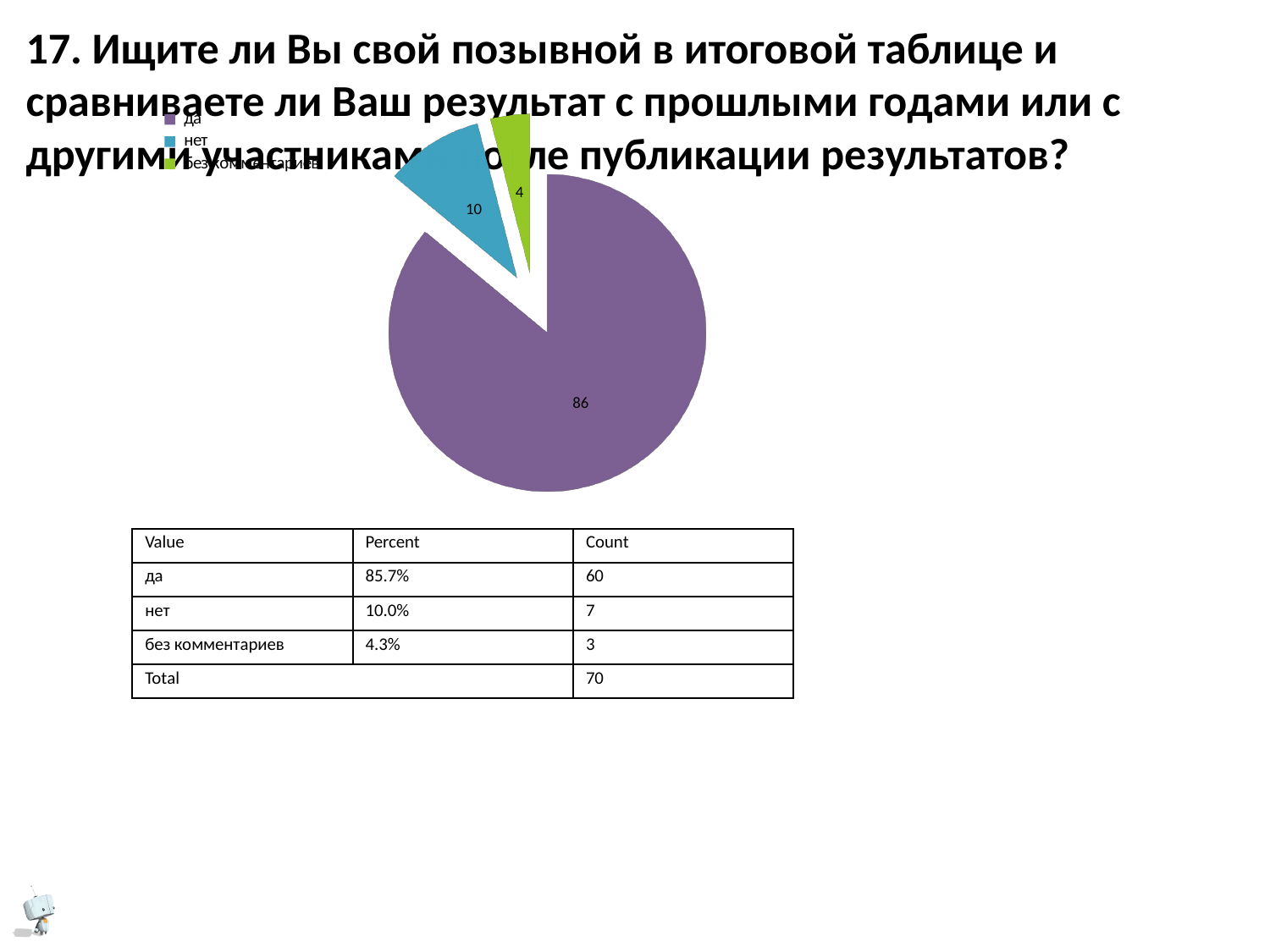
What value is printed on the largest slice of the pie chart? 86 Which slice is larger in the pie chart, "нет" or "без комментариев"? нет What kind of chart is shown on the slide? pie chart What is the difference between the values printed on the "да" slice and the "нет" slice? 76 Which category has the smallest slice in the pie chart? без комментариев What value is printed on the slice for "нет" in the pie chart? 10 What value is printed on the smallest slice of the pie chart? 4 What colour is the slice labelled 4 in the pie chart? green How many entries does the legend of the pie chart list? 3 Which category has the largest slice in the pie chart? да How many slices does the pie chart have? 3 What colour is the largest slice of the pie chart? purple